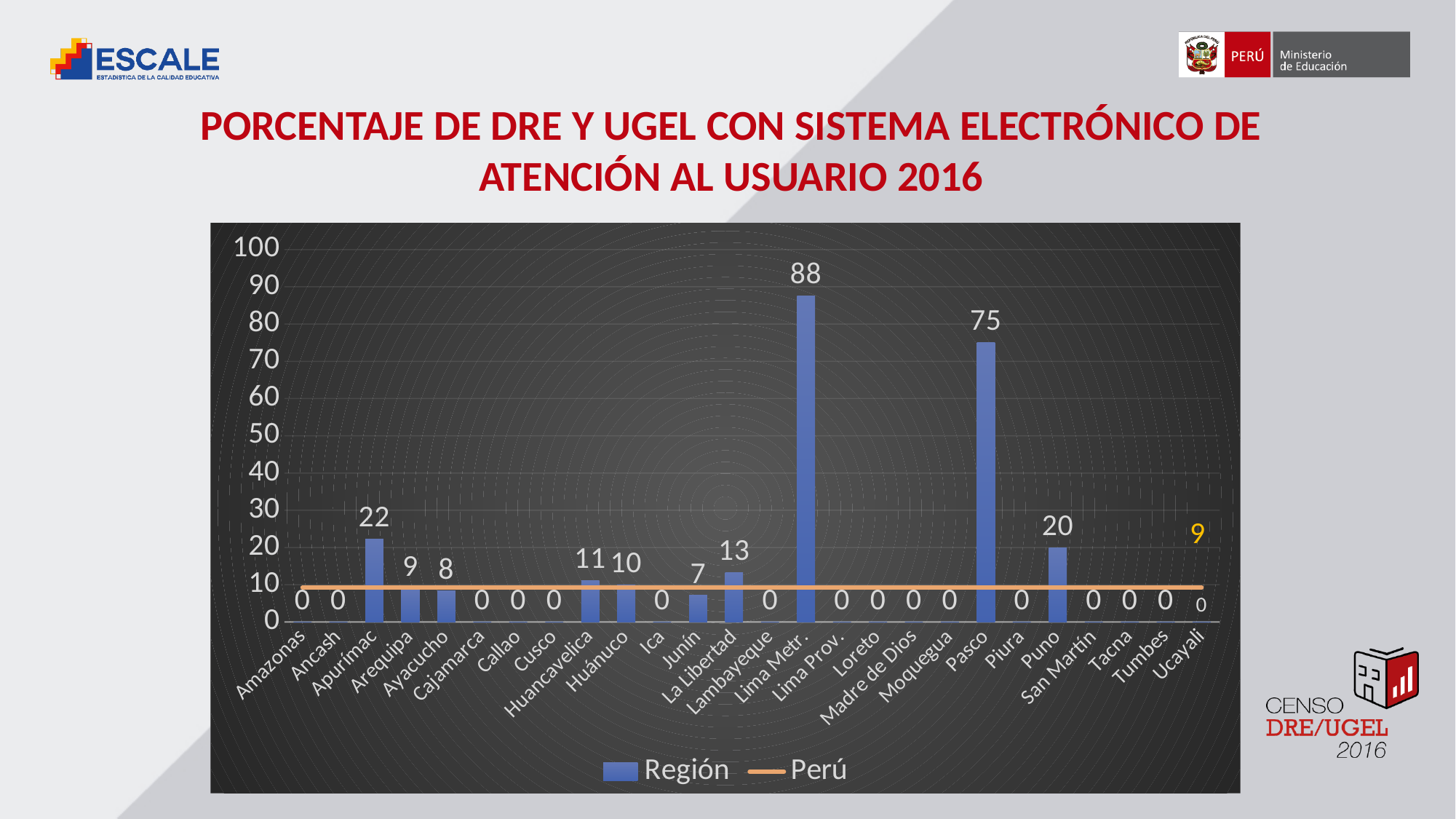
What is the value for Apurímac? 22 What kind of chart is shown on the slide? Combination bar and line chart Which region has the highest value? Lima Metr. What is the value for Lima Metr.? 88 What is the value for Huancavelica? 11 What are the two entries in the chart legend? Región and Perú How many series does the legend list? 2 What is the value for Pasco? 75 What is the difference between the values for Lima Metr. and Pasco? 13 How many regions are shown on the x axis? 26 Which is larger, the value for Puno or the value for La Libertad? Puno What value does the Perú line show? 9